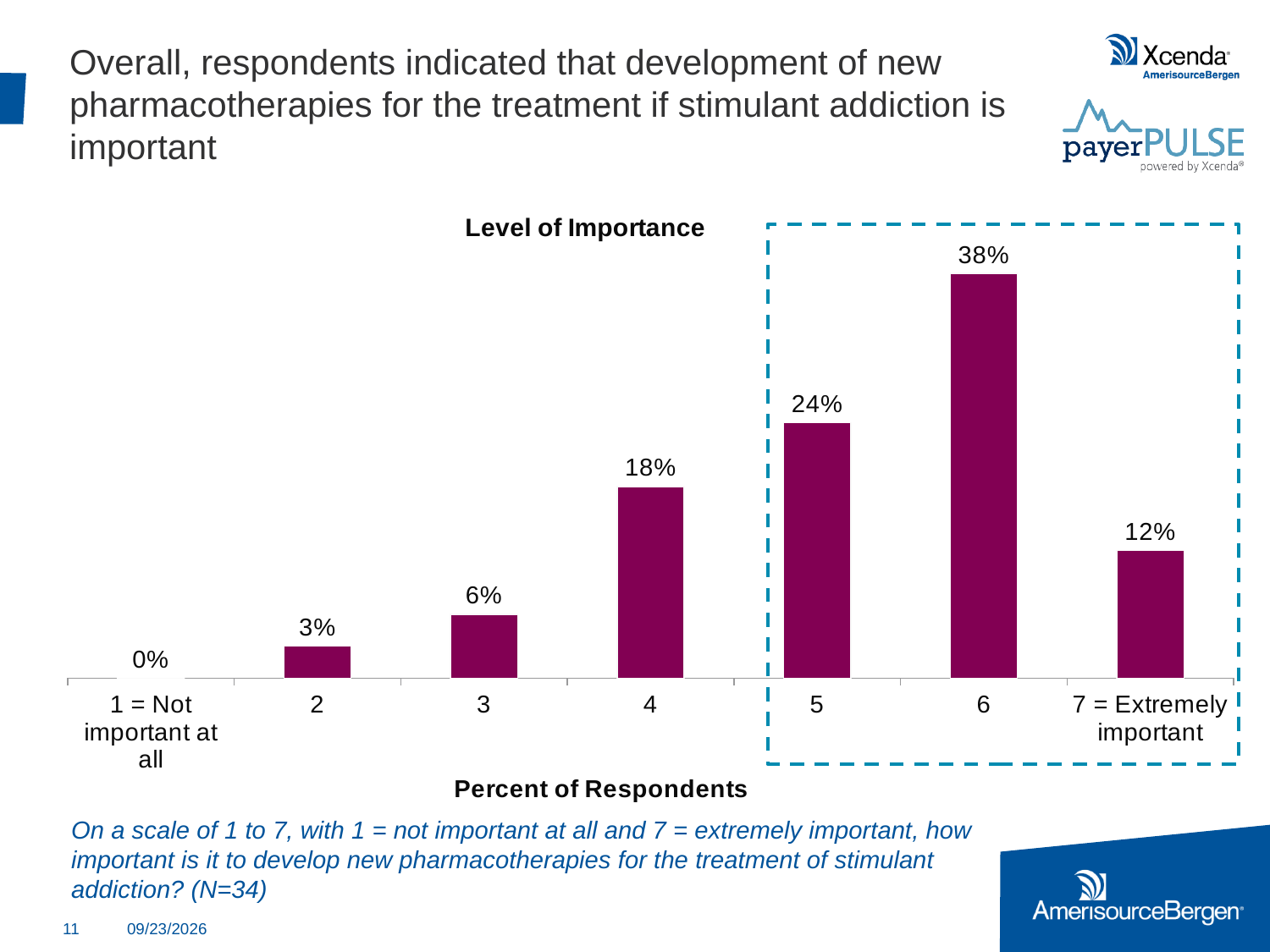
What is the combined percentage of respondents who rated importance as 5, 6, or 7? 74% What is the title of the chart? Level of Importance How many rating categories are shown on the x axis? 7 What percentage of respondents chose 7 = Extremely important? 12% What type of chart is shown on the slide? Bar chart Which has a larger share of respondents, rating 4 or rating 7 = Extremely important? 4 What percentage of respondents rated the importance as 4? 18% What percentage of respondents chose 1 = Not important at all? 0% What is the difference in percentage points between rating 6 and rating 5? 14 Which rating level has the lowest percentage of respondents? 1 = Not important at all What percentage of respondents rated the level of importance as 6? 38% Which rating level has the highest percentage of respondents? 6